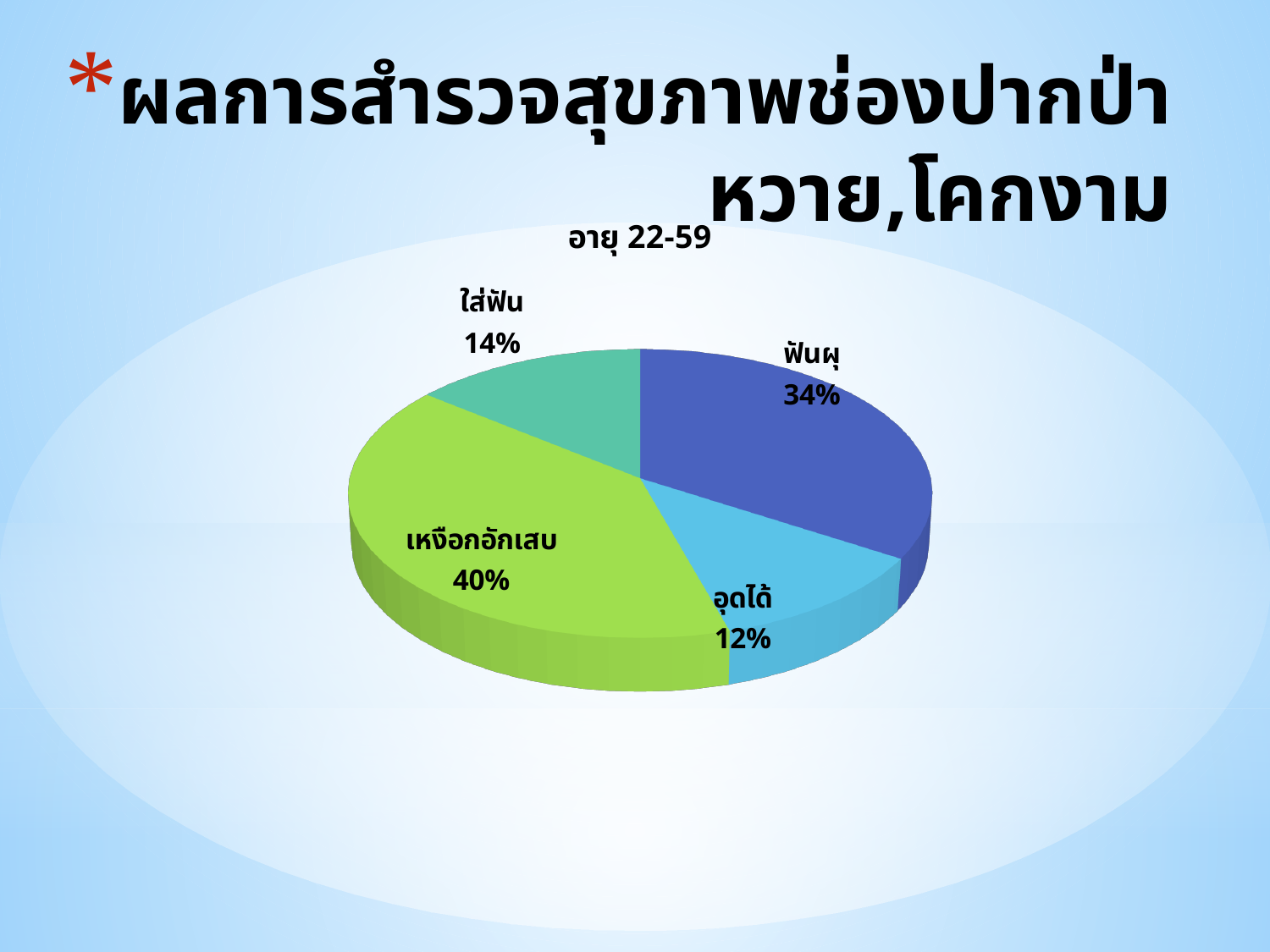
What is the difference in percentage points between เหงือกอักเสบ and ฟันผุ? 6 What colour is the slice for เหงือกอักเสบ? green What type of chart is shown on the slide? pie chart What percentage is shown for ใส่ฟัน? 14% Which category has the smallest share of the pie? อุดได้ How many slices does the pie chart have? 4 Which category has the largest share of the pie? เหงือกอักเสบ What percentage is shown for ฟันผุ? 34% What is the title of the chart? อายุ 22-59 Which is larger, ใส่ฟัน or อุดได้? ใส่ฟัน What percentage is shown for อุดได้? 12% What percentage is shown for เหงือกอักเสบ? 40%